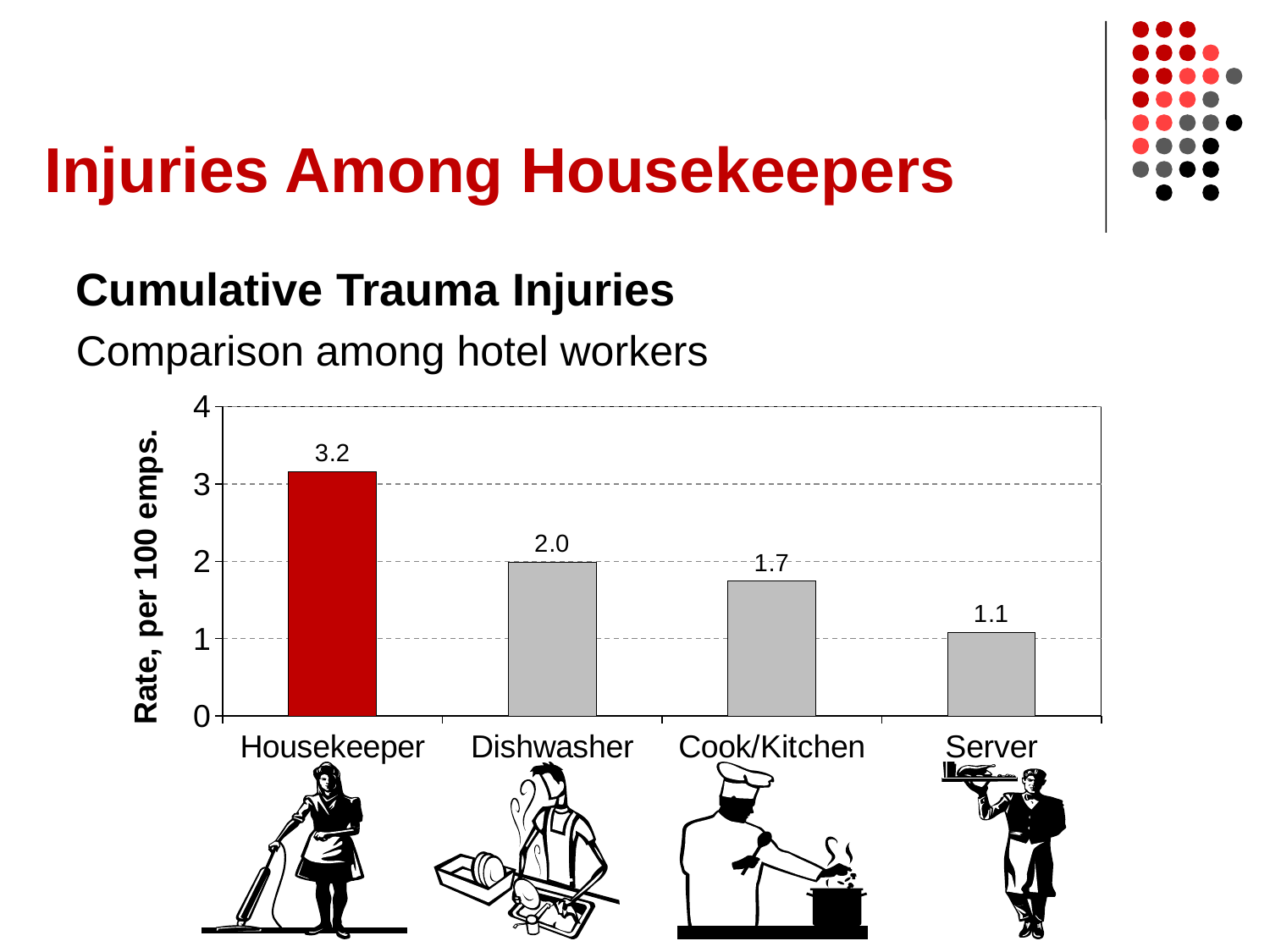
How many worker categories are shown in the chart? 4 What is the cumulative trauma injury rate for Housekeeper? 3.2 What kind of chart is shown on the slide? Bar chart What is the difference between the injury rates for Housekeeper and Dishwasher? 1.2 What is the difference between the injury rates for Cook/Kitchen and Server? 0.6 Which has a higher injury rate, Dishwasher or Cook/Kitchen? Dishwasher What is the cumulative trauma injury rate for Cook/Kitchen? 1.7 What is the cumulative trauma injury rate for Dishwasher? 2.0 What is the label of the vertical axis of the chart? Rate, per 100 emps. Which hotel worker category has the lowest injury rate? Server What is the cumulative trauma injury rate for Server? 1.1 Which hotel worker category has the highest injury rate? Housekeeper